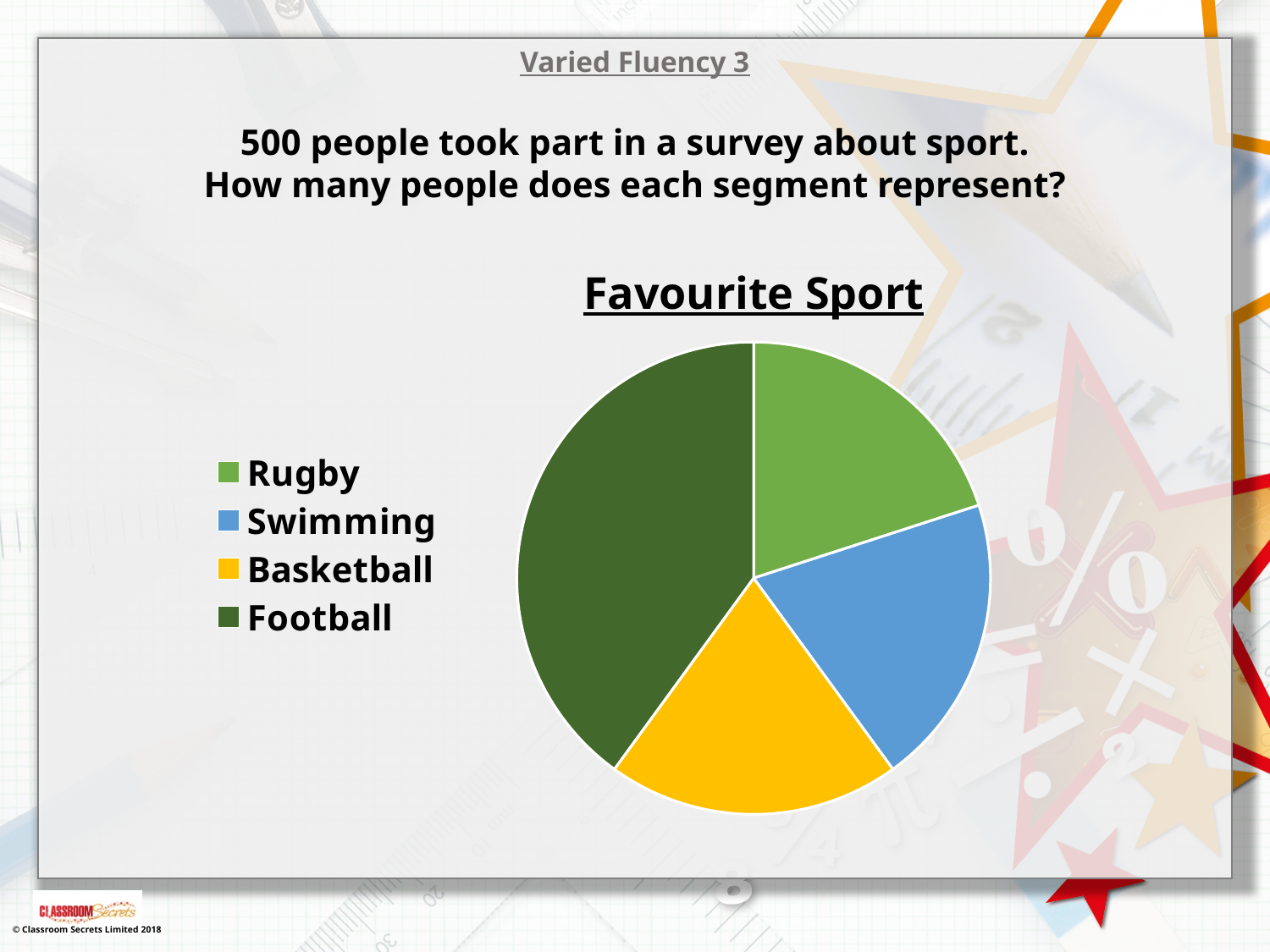
How many segments does the pie chart have? 4 Which segment is larger, Football or Rugby? Football Which segment is larger, Swimming or Football? Football How many entries does the legend list? 4 What kind of chart is shown on the slide? pie chart Which segment is larger, Basketball or Football? Football What is the title of the chart? Favourite Sport Which sport has the largest segment in the pie chart? Football Which colour represents Football in the pie chart? dark green